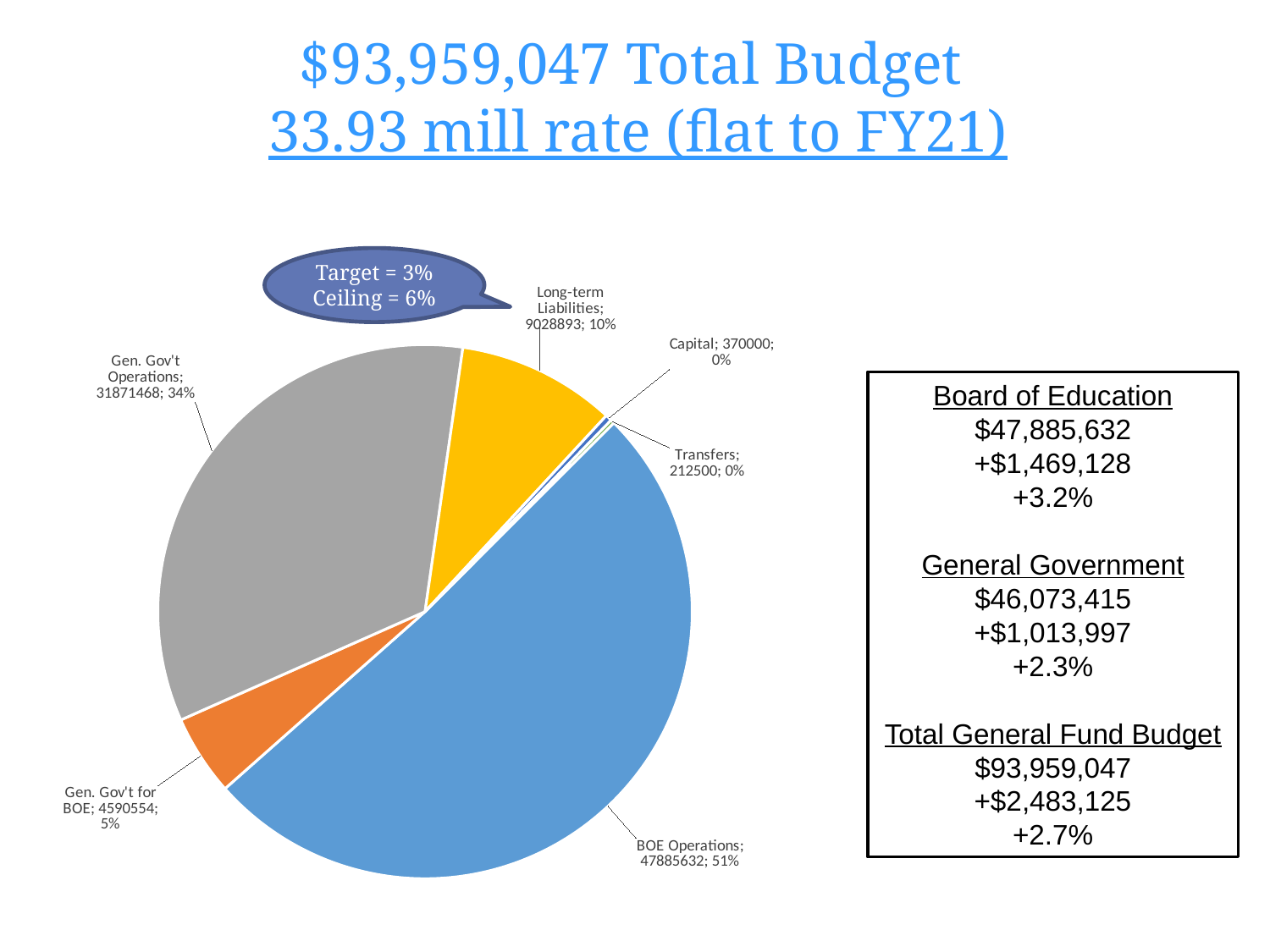
How many slices does the pie chart have? 6 What is the difference between the Capital value and the Transfers value in the pie chart? 157500 Which category has the largest slice in the pie chart? BOE Operations What type of chart is shown on the slide? pie chart What share of the pie does BOE Operations represent? 51% What is the value shown for BOE Operations in the pie chart? 47885632 What share of the pie does Gen. Gov't Operations represent? 34% Which category has the smallest slice in the pie chart? Transfers What is the value shown for Gen. Gov't for BOE in the pie chart? 4590554 What is the value shown for Long-term Liabilities in the pie chart? 9028893 Which is larger in the pie chart, Long-term Liabilities or Gen. Gov't for BOE? Long-term Liabilities What is the value shown for Gen. Gov't Operations in the pie chart? 31871468